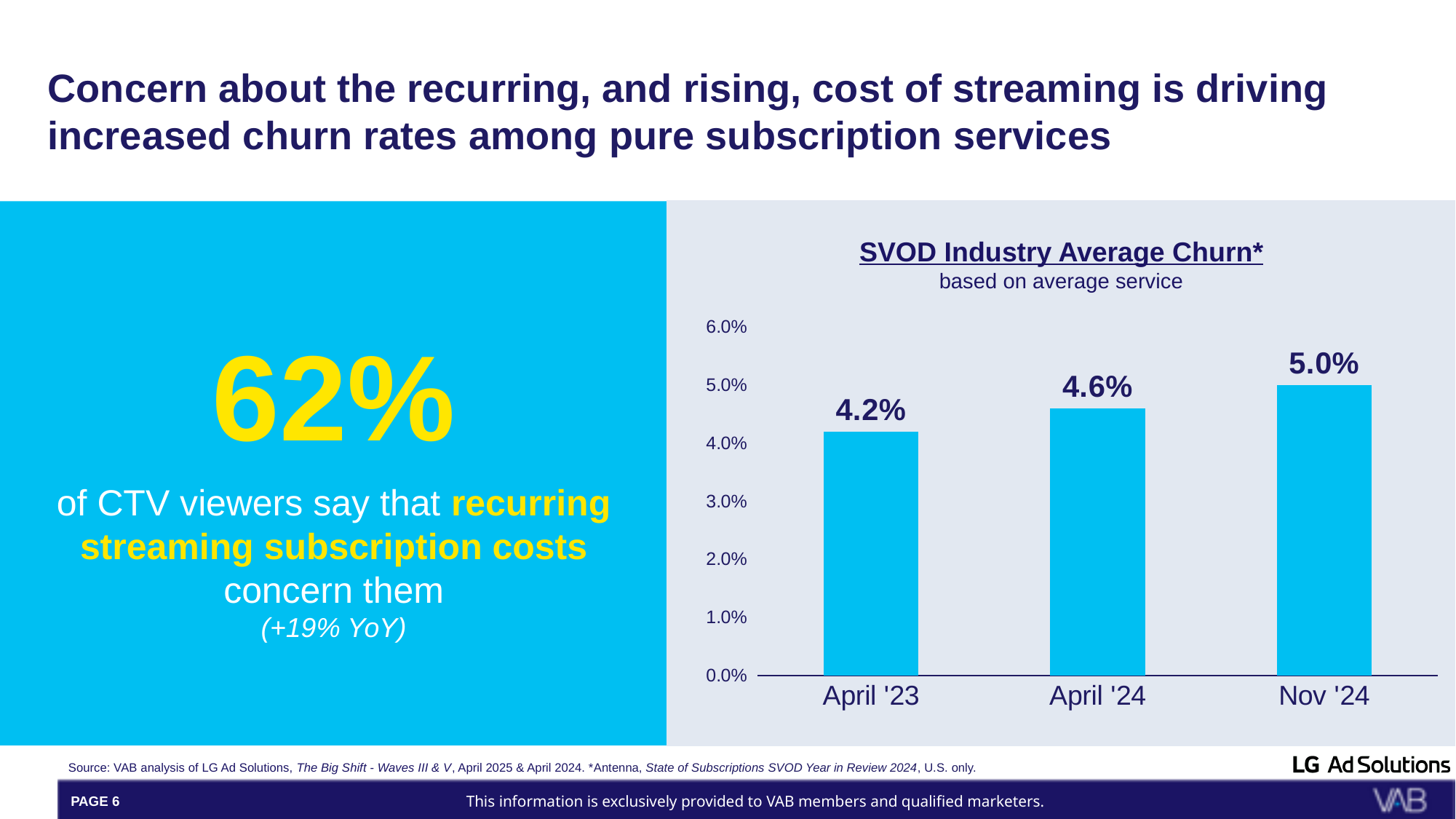
Is the churn value for April '23 greater or less than 4.0%? greater What is the SVOD industry average churn for Nov '24? 5.0% Which period has the lowest average churn? April '23 Which is larger, the churn for April '24 or for Nov '24? Nov '24 What kind of chart is used to show SVOD industry average churn? bar chart What is the SVOD industry average churn for April '23? 4.2% What is the difference in churn between April '24 and April '23? 0.4% Do the churn values rise or fall from April '23 to Nov '24? rise What is the SVOD industry average churn for April '24? 4.6% What is the difference in churn between Nov '24 and April '23? 0.8% How many periods are shown on the chart? 3 Which period has the highest average churn? Nov '24